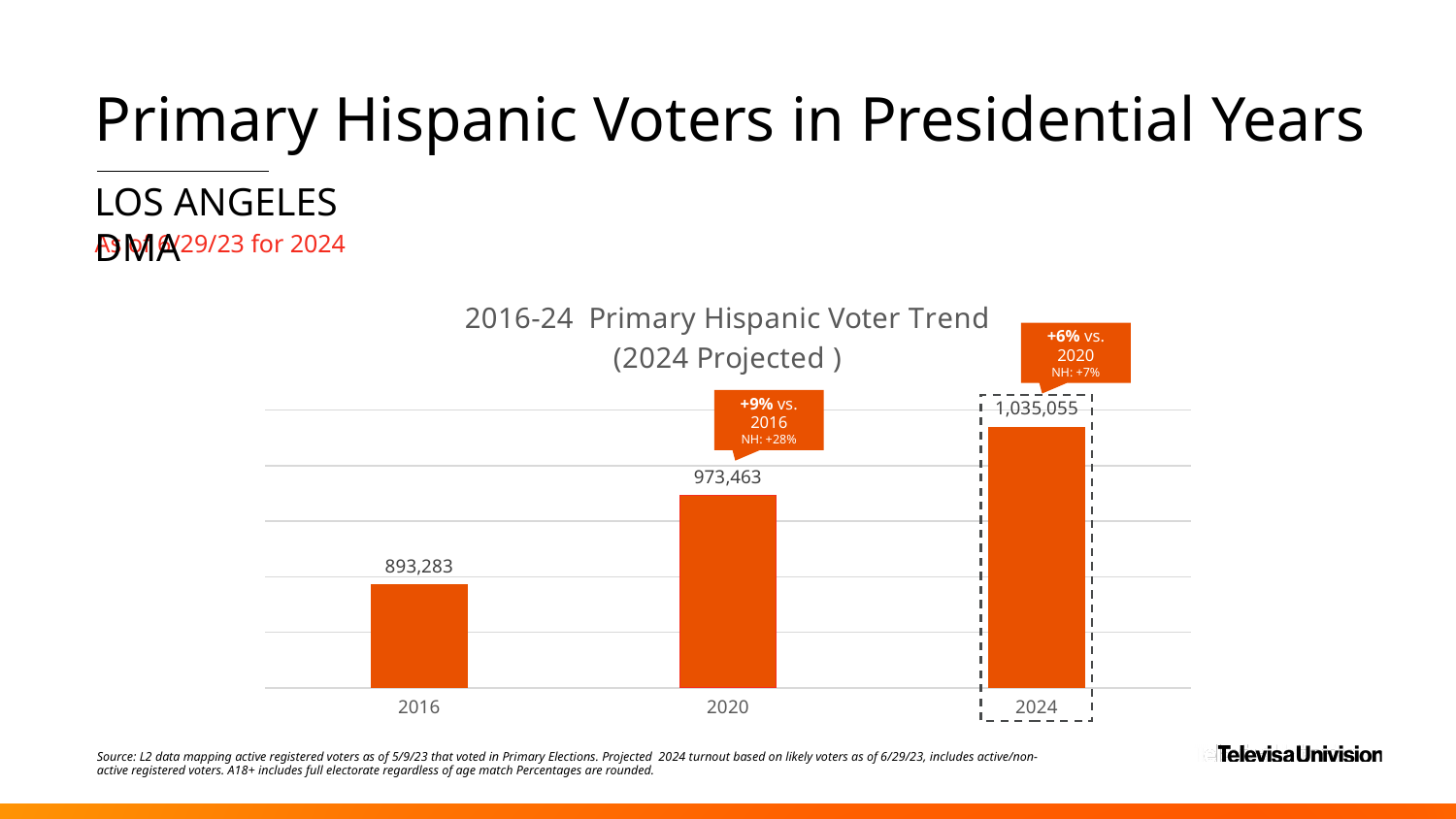
What kind of chart is shown? Bar chart What is the value for 2016? 893,283 Which is larger, the value for 2016 or the value for 2020? 2020 What is the difference between the 2024 and 2020 values? 61,592 What is the difference between the 2020 and 2016 values? 80,180 Do the values rise or fall from 2016 to 2024? Rise How many years are shown on the x axis? 3 What is the title of the chart? 2016-24 Primary Hispanic Voter Trend (2024 Projected ) Which year has the lowest value? 2016 What is the value for 2020? 973,463 What is the projected value for 2024? 1,035,055 Which year has the highest value? 2024